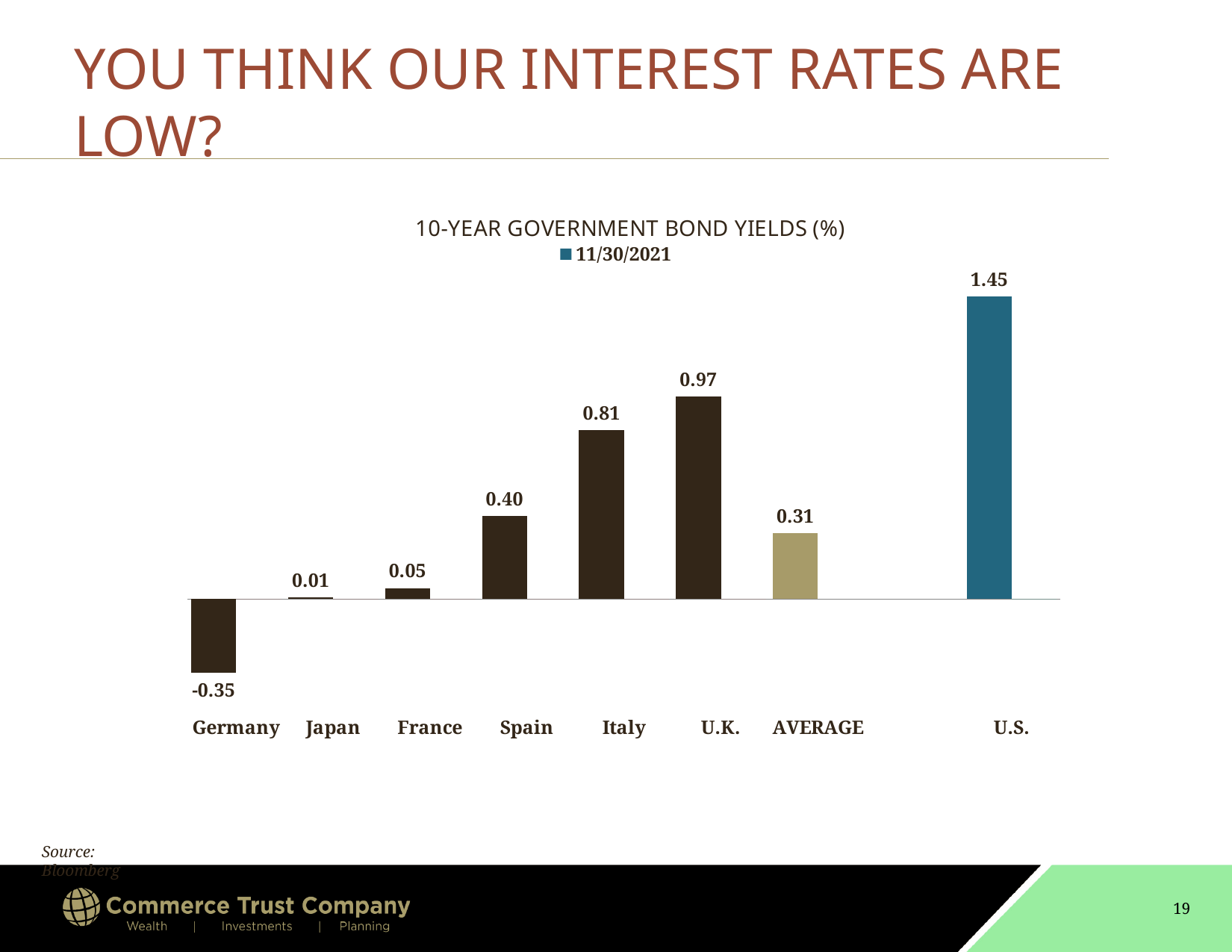
What is the difference between the U.S. yield and the U.K. yield? 0.48 What date does the chart legend show for the data? 11/30/2021 How many categories are shown on the x axis of the chart? 8 Which category has the lowest 10-year government bond yield? Germany What is the value shown for the AVERAGE bar? 0.31 What kind of chart is shown on the slide? Bar chart What is the 10-year government bond yield shown for Germany? -0.35 How many series does the chart legend list? 1 Which has a higher 10-year bond yield, Italy or Spain? Italy What is the difference between the Spain yield and the France yield? 0.35 Which category has the highest 10-year government bond yield? U.S. What is the 10-year government bond yield shown for Italy? 0.81